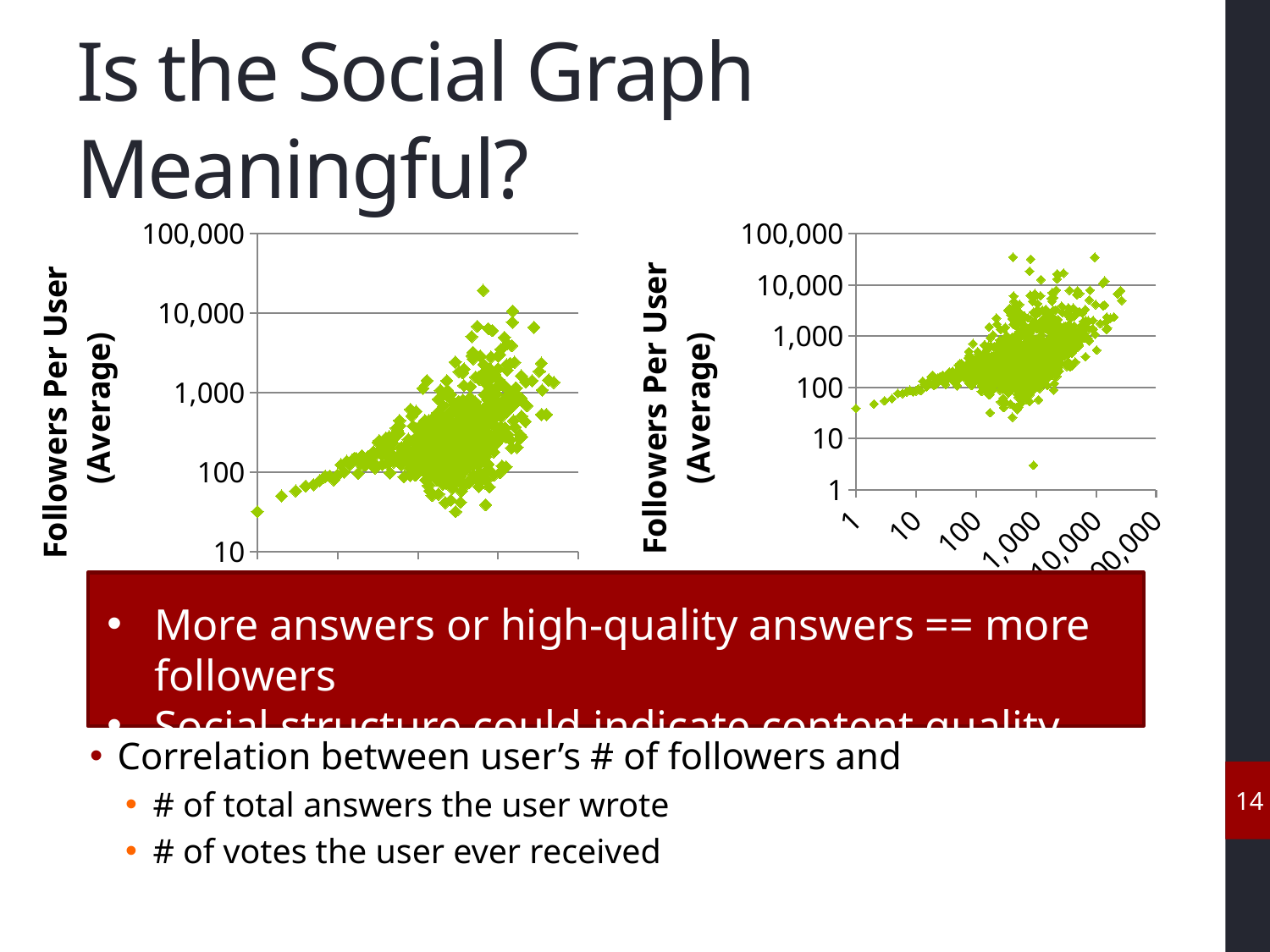
What kind of chart is the chart on the right of the slide? scatter chart How many charts are shown on the slide? 2 In the left chart, do the plotted values generally rise or fall as you move along the x axis? rise What kind of chart is the chart on the left of the slide? scatter chart What is the y-axis label of the left chart? Followers Per User (Average) In the right chart, do the plotted values generally rise or fall as you move along the x axis? rise